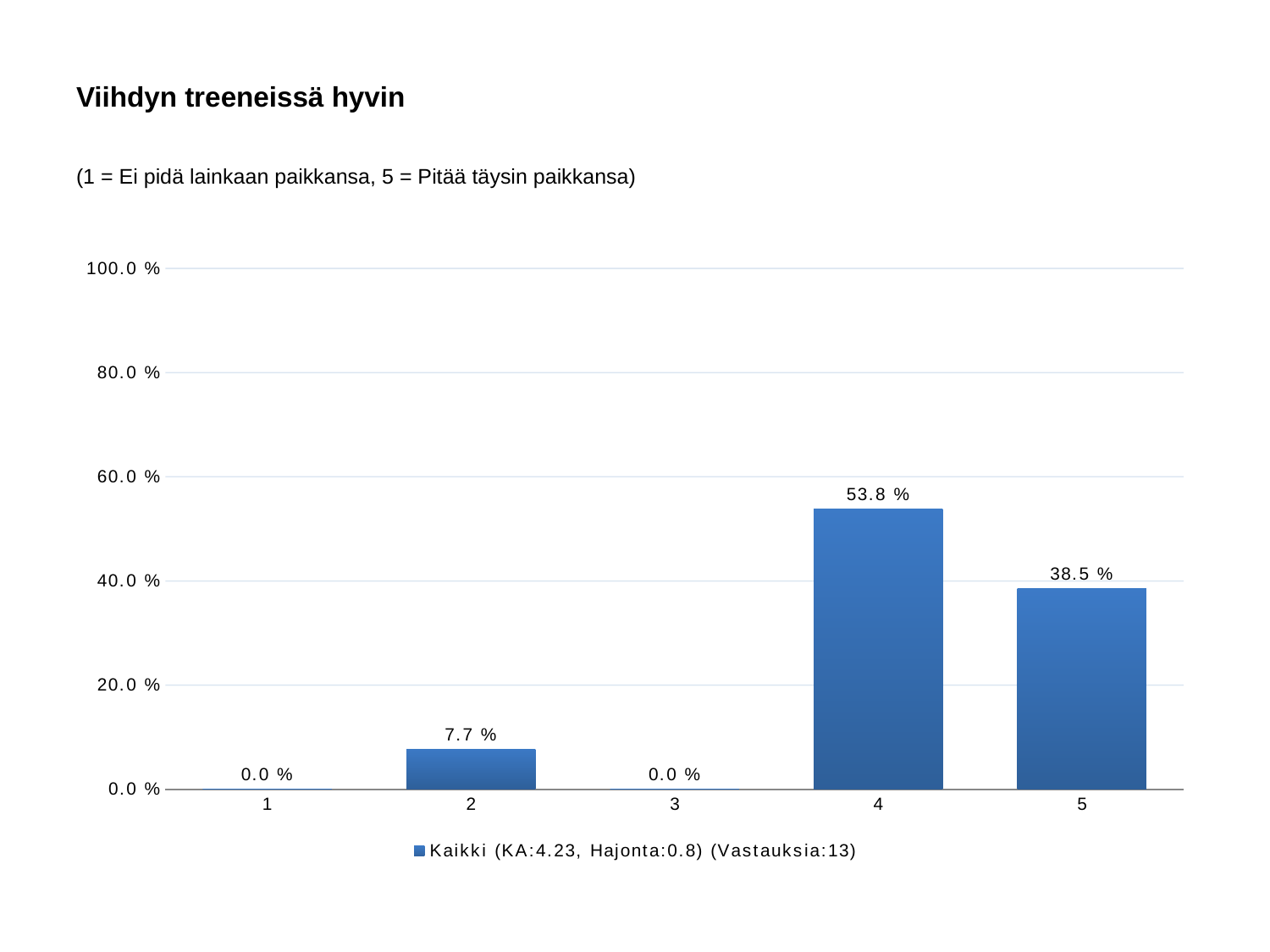
What is the value for category 2? 7.7 % What is the value for category 1? 0.0 % What is the difference between the values for categories 4 and 5? 15.3 % What is the title of the slide? Viihdyn treeneissä hyvin Which category has the highest value? 4 What is the value for category 4? 53.8 % Is the value for category 4 greater or less than 60.0 %? less How many series does the legend list? 1 What kind of chart is shown on the slide? bar chart How many categories are shown on the x axis? 5 What is the value for category 5? 38.5 % Which is larger, the value for category 2 or the value for category 5? 5